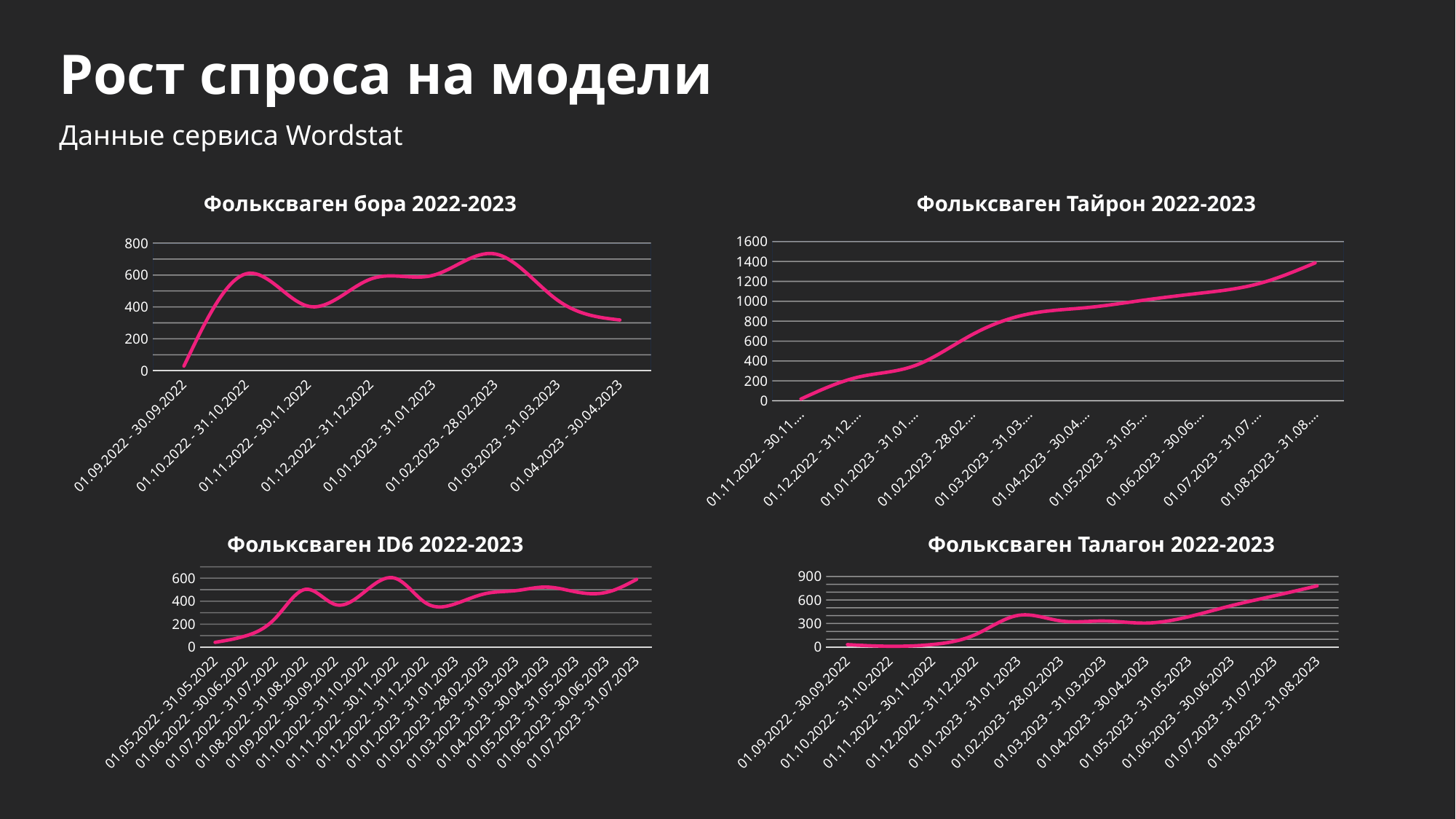
In the "Фольксваген Талагон 2022-2023" chart, which period has the highest value? 01.08.2023 - 31.08.2023 In the "Фольксваген бора 2022-2023" chart, is the value for 01.02.2023 - 28.02.2023 greater or less than 600? greater How many charts are shown on the slide? 4 In the "Фольксваген ID6 2022-2023" chart, how many periods are plotted on the x axis? 15 In the "Фольксваген Тайрон 2022-2023" chart, how many periods are plotted on the x axis? 10 What type of chart is "Фольксваген бора 2022-2023"? line chart In the "Фольксваген бора 2022-2023" chart, which period has the lowest value? 01.09.2022 - 30.09.2022 In the "Фольксваген бора 2022-2023" chart, how many periods are plotted on the x axis? 8 In the "Фольксваген Тайрон 2022-2023" chart, do the values rise or fall along the x axis? rise In the "Фольксваген бора 2022-2023" chart, which period has the highest value? 01.02.2023 - 28.02.2023 In the "Фольксваген ID6 2022-2023" chart, is the value for 01.05.2022 - 31.05.2022 greater or less than 200? less In the "Фольксваген Тайрон 2022-2023" chart, is the value for the last period (01.08.2023 - 31.08.2023) greater or less than 1200? greater